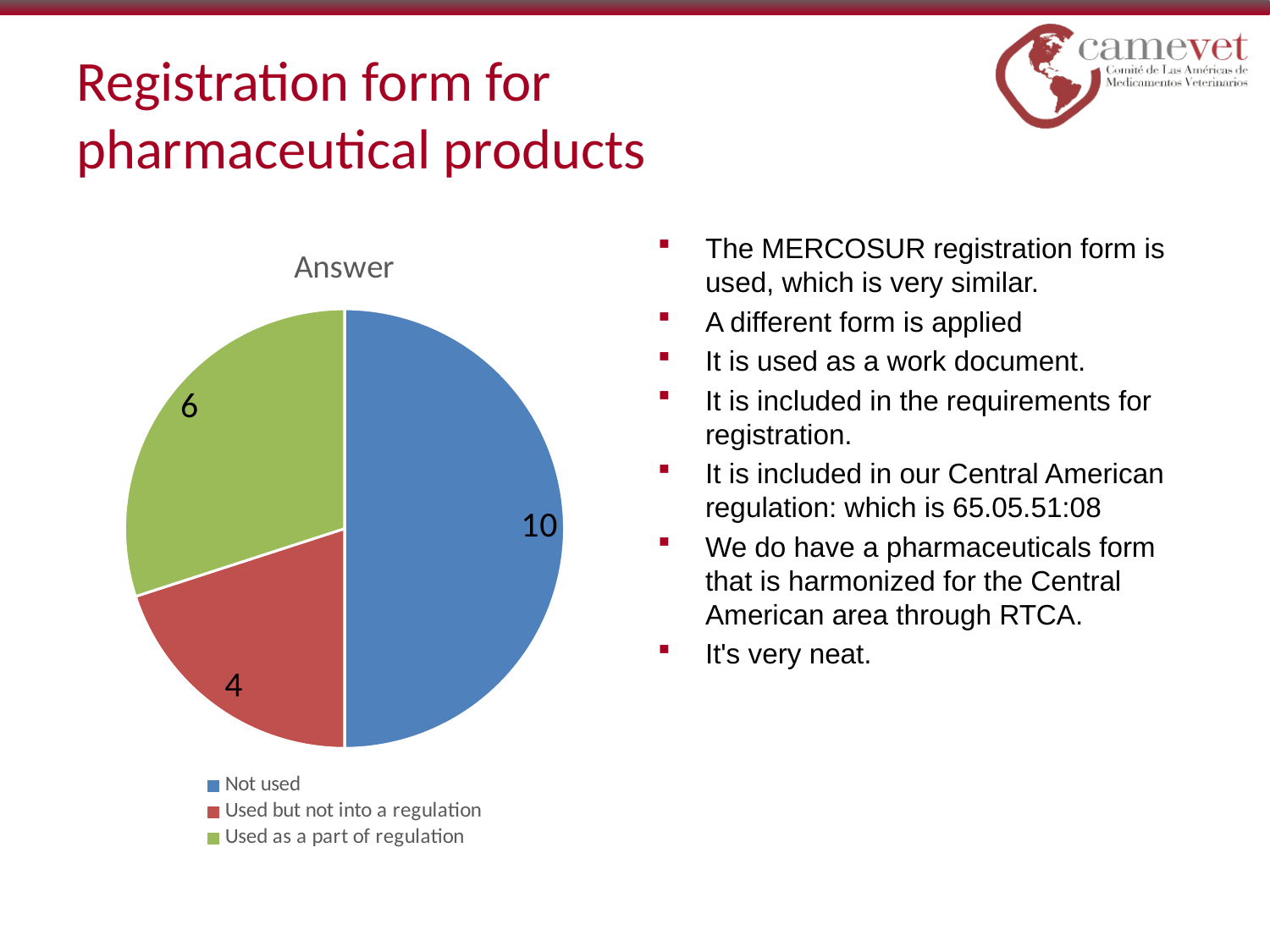
How many slices does the pie chart have? 3 What is the title of the chart? Answer Which colour represents "Used as a part of regulation" in the legend? green What is the value for "Used but not into a regulation"? 4 What share of the pie does the "Not used" slice represent? 50% What is the value for "Not used"? 10 Which category has the largest slice? Not used Which category has the smallest slice? Used but not into a regulation What is the value for "Used as a part of regulation"? 6 What is the difference between the values for "Not used" and "Used as a part of regulation"? 4 What type of chart is shown on the slide? pie chart Which is larger, the value for "Used as a part of regulation" or the value for "Used but not into a regulation"? Used as a part of regulation